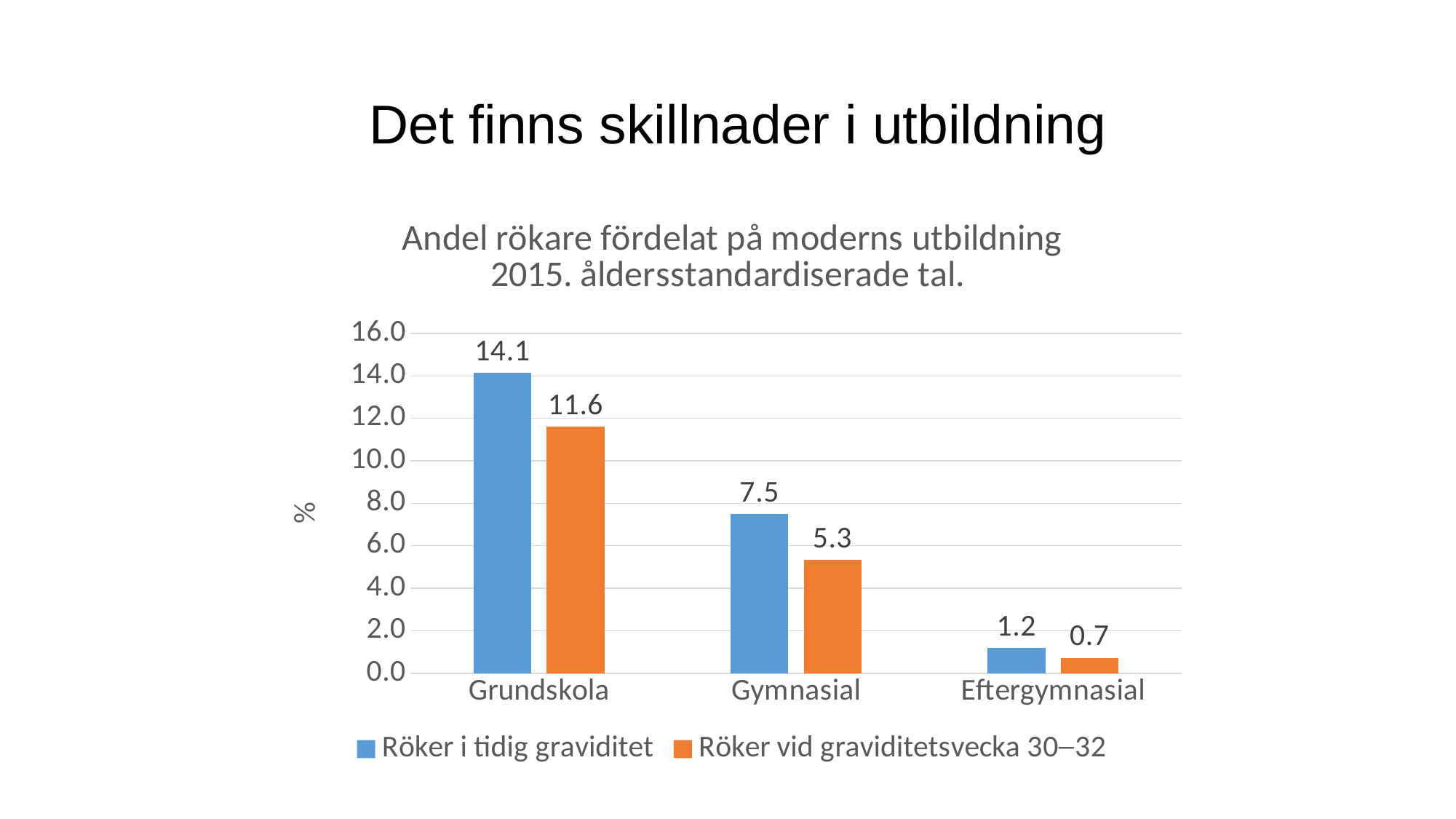
What is the difference between the 'Röker i tidig graviditet' values for Grundskola and Gymnasial? 6.6 What is the difference between the two series for Grundskola? 2.5 How many series does the legend list? 2 What kind of chart is shown on the slide? Bar chart What is the value for Eftergymnasial in the series 'Röker i tidig graviditet'? 1.2 Which education category has the lowest value for 'Röker vid graviditetsvecka 30–32'? Eftergymnasial How many education categories are shown on the x axis? 3 Which education category has the highest value for 'Röker i tidig graviditet'? Grundskola What is the value for Grundskola in the series 'Röker i tidig graviditet'? 14.1 Do the values for 'Röker i tidig graviditet' rise or fall from Grundskola to Eftergymnasial? Fall Which is larger for Gymnasial: 'Röker i tidig graviditet' or 'Röker vid graviditetsvecka 30–32'? Röker i tidig graviditet What is the value for Gymnasial in the series 'Röker vid graviditetsvecka 30–32'? 5.3